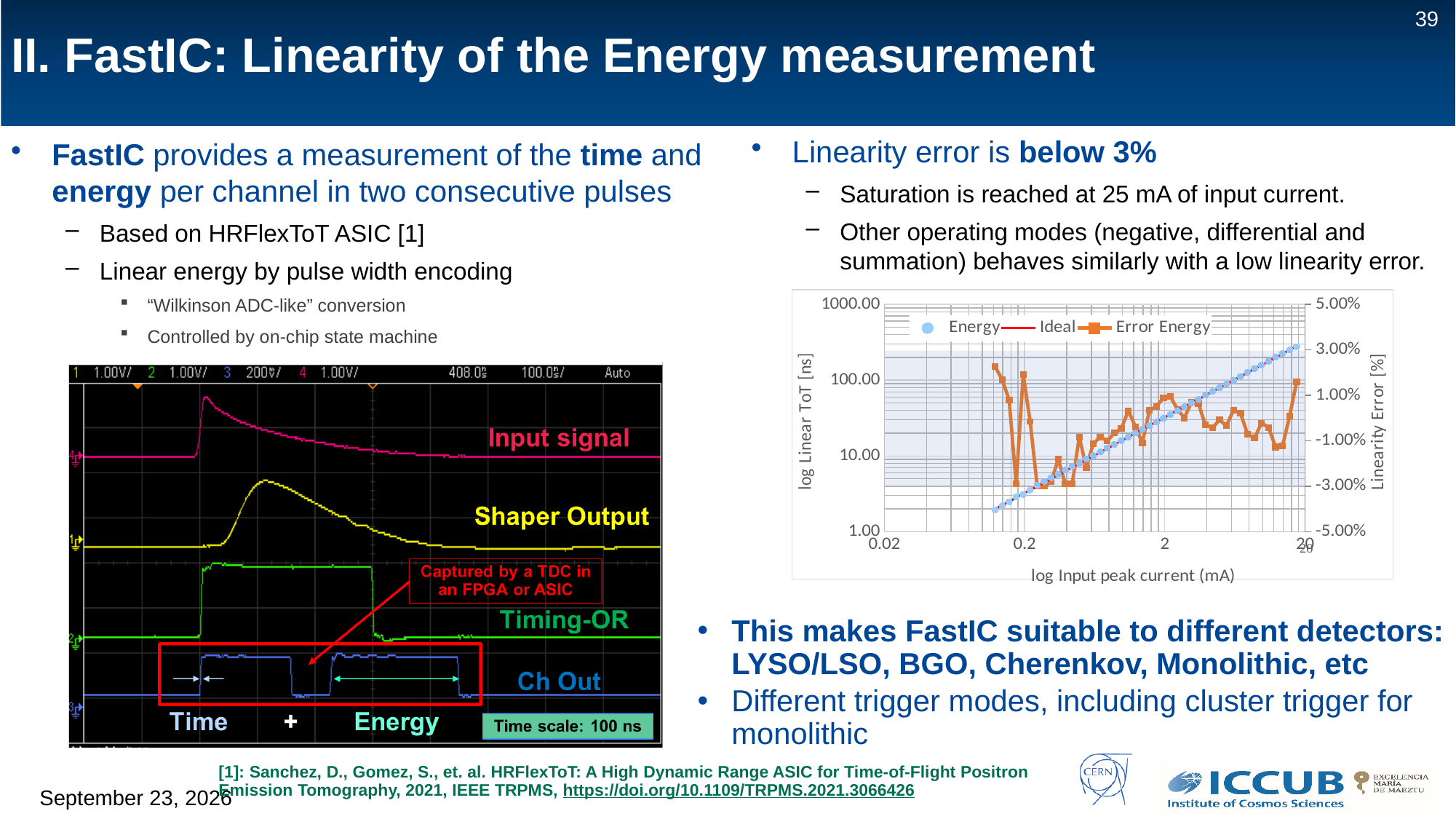
What is the title of the x axis of the linearity chart? log Input peak current (mA) What kind of chart is shown on the right side of the slide? scatter/line chart What is the lowest tick value shown on the x axis of the linearity chart? 0.02 What is the highest tick value shown on the left y axis of the linearity chart? 1000.00 What is the highest tick value shown on the right y axis of the linearity chart? 5.00% How many series does the legend of the linearity chart list? 3 How many tick labels are shown on the x axis of the linearity chart? 4 What are the three series named in the legend of the linearity chart? Energy, Ideal, Error Energy In the linearity chart, does the Energy series rise or fall as the input peak current increases? rise In the linearity chart, is the Energy value at 0.2 mA greater or less than 10? less In the linearity chart, is the Energy value at 2 mA greater or less than 100? less In the linearity chart, is the Energy value at 20 mA greater or less than 100? greater